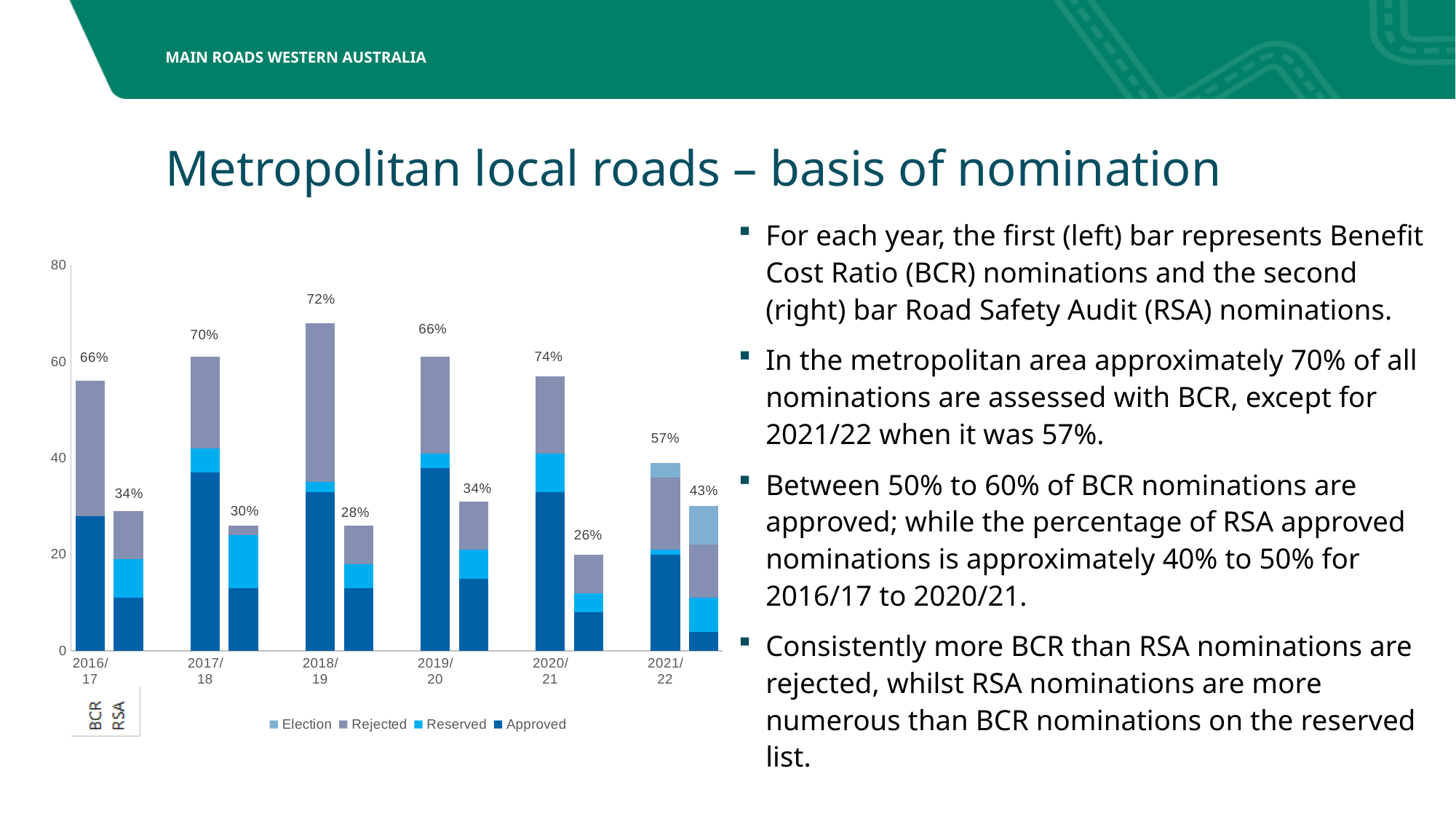
Which is larger: the BCR percentage label for 2017/18 or for 2019/20? 2017/18 What type of chart is shown on the slide? Stacked bar chart What is the difference between the BCR and RSA percentage labels for 2016/17? 32 percentage points How many years are shown on the x axis of the chart? 6 Which year has the lowest percentage label on its RSA bar? 2020/21 How many series does the chart legend list? 4 What percentage label is shown above the RSA bar for 2021/22? 43% Is the total height of the RSA bar for 2017/18 greater or less than 20? greater Which year has the highest percentage label on its BCR bar? 2020/21 What percentage label is shown above the RSA bar for 2019/20? 34% What percentage label is shown above the BCR bar for 2018/19? 72% Is the total height of the BCR bar for 2018/19 greater or less than 60? greater